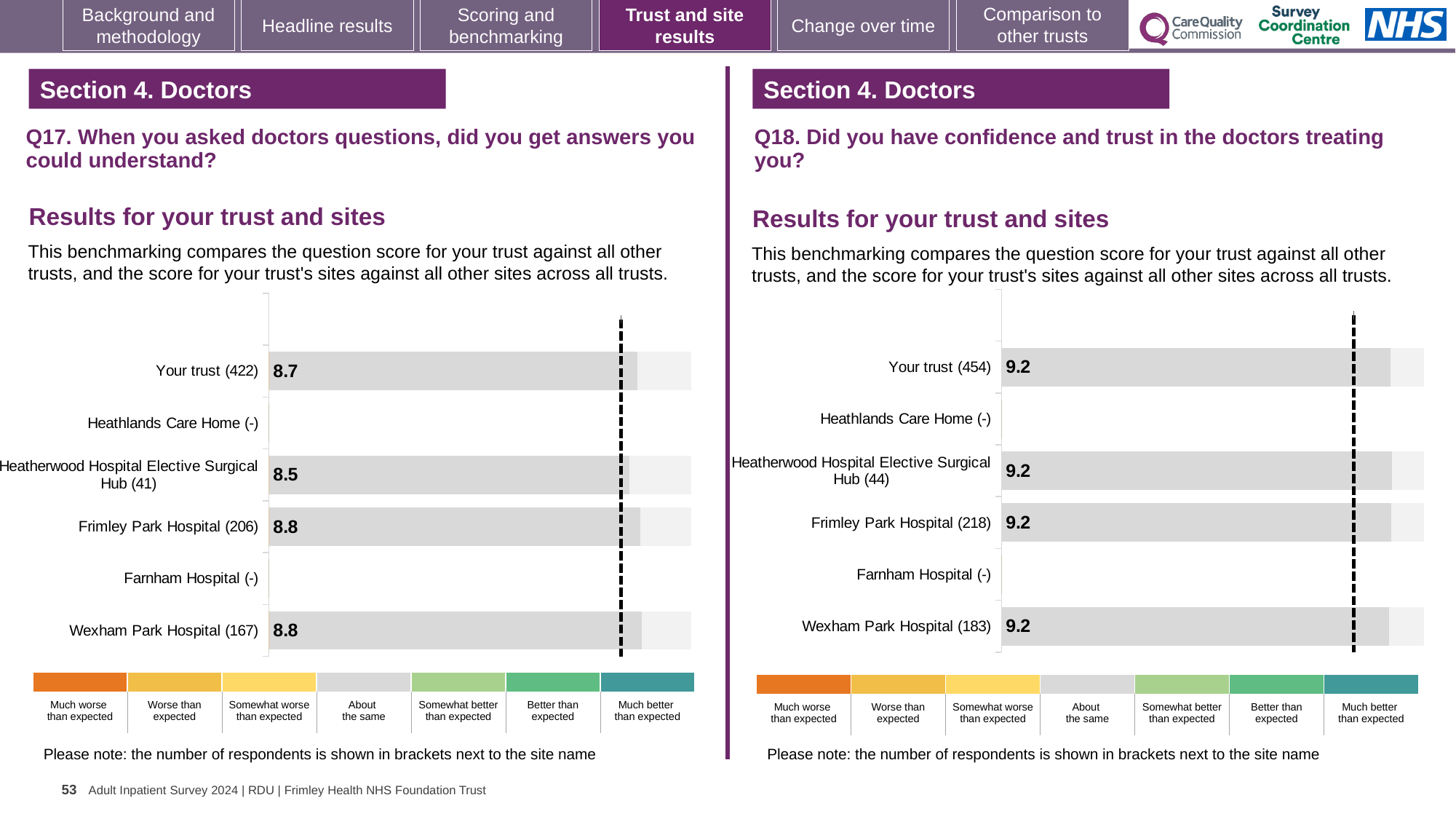
On the Q17 chart (left), what is the score for Frimley Park Hospital? 8.8 On the Q17 chart (left), which is larger: the score for Wexham Park Hospital or the score for Your trust? Wexham Park Hospital On the Q17 chart (left), which site has the lowest score among those with a value shown? Heatherwood Hospital Elective Surgical Hub On the Q17 chart (left), what is the score for Heatherwood Hospital Elective Surgical Hub? 8.5 On the Q17 chart (left), what is the score for Your trust? 8.7 On the Q18 chart (right), what is the score for Your trust? 9.2 On the Q18 chart (right), what is the score for Wexham Park Hospital? 9.2 On the Q18 chart (right), how many respondents are shown in brackets for Frimley Park Hospital? 218 On the Q17 chart (left), what is the difference between the scores for Frimley Park Hospital and Heatherwood Hospital Elective Surgical Hub? 0.3 What kind of chart is used on the Q18 chart (right)? bar chart On the Q17 chart (left), how many respondents are shown in brackets for Your trust? 422 On the Q17 chart (left), how many rows (sites including Your trust) are listed on the axis? 6